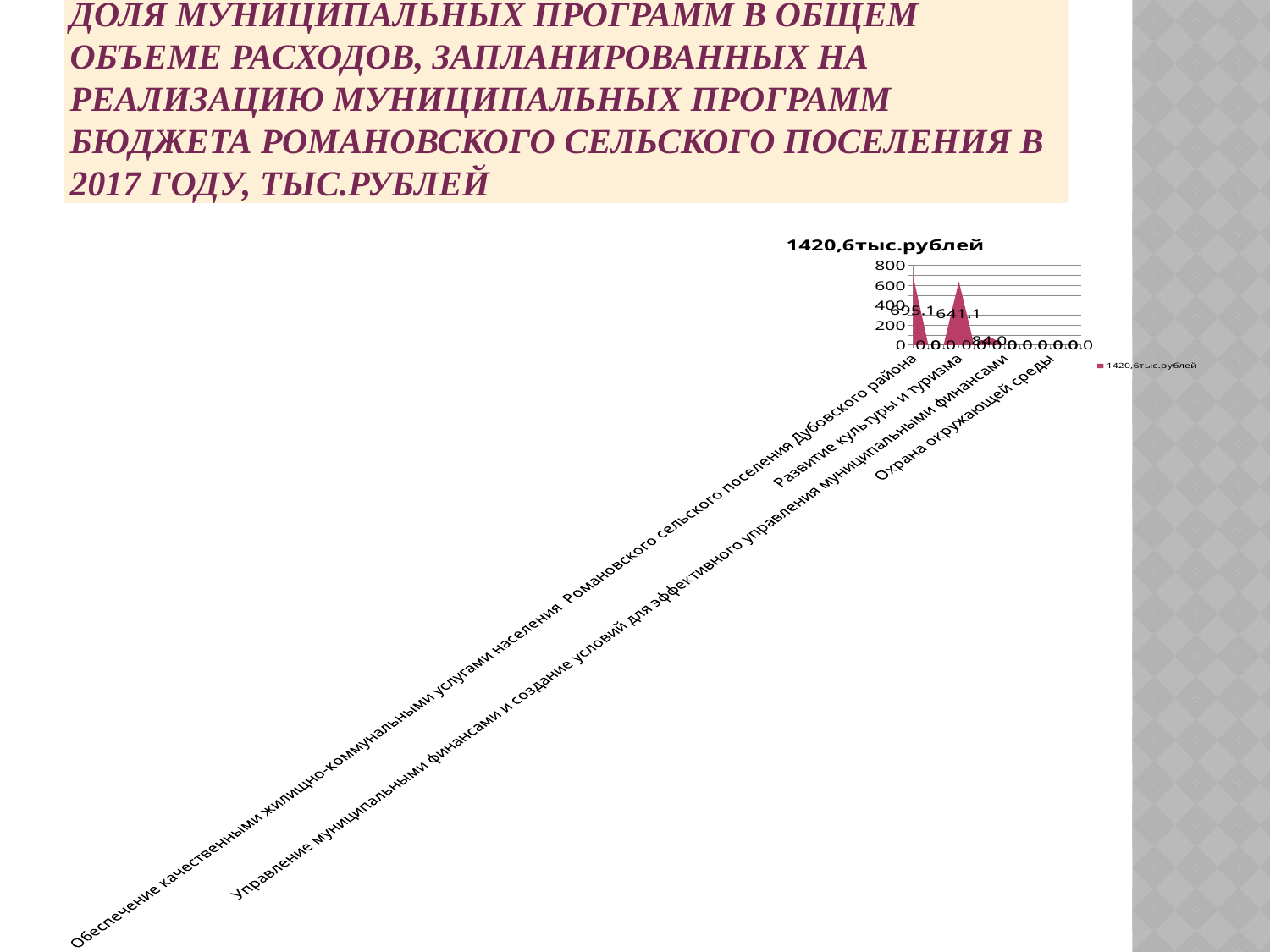
What is the smallest non-zero value labelled on the chart? 84.0 Is the tallest peak on the chart greater or less than 600? greater What is the legend entry of the chart? 1420,6тыс.рублей What is the highest value labelled on the chart? 695.1 What is the difference between the two largest labelled values, 695.1 and 641.1? 54.0 How many series does the chart legend list? 1 What is the highest tick shown on the vertical axis of the chart? 800 What kind of chart is shown on the slide? area chart Which is larger, the value labelled 695.1 or the value labelled 641.1? 695.1 What is the title of the chart? 1420,6тыс.рублей